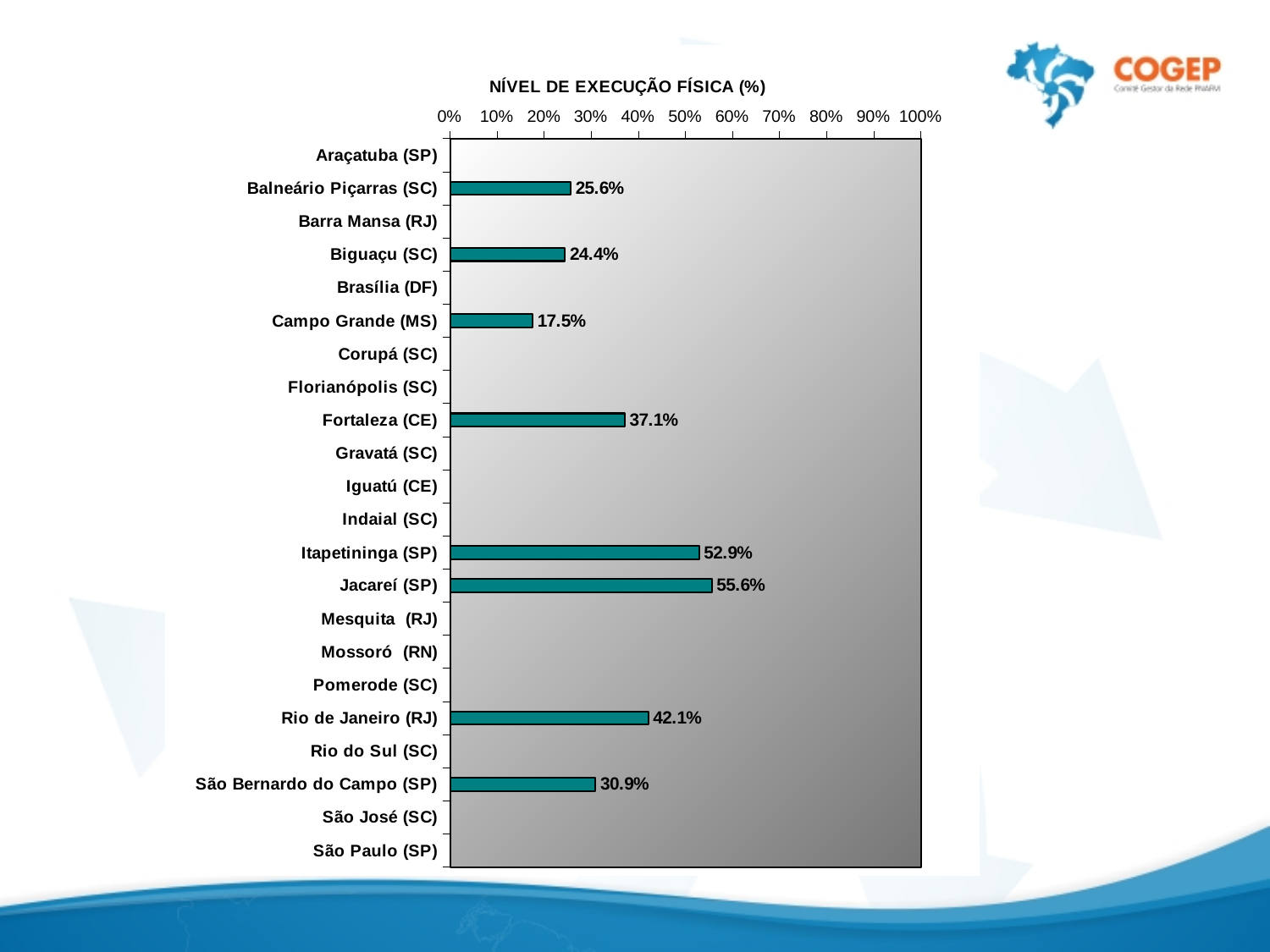
How many cities are listed on the vertical axis of the chart? 22 How many cities have a bar with a value shown in the chart? 8 What is the value for São Bernardo do Campo (SP)? 30.9% What is the difference between the values for Jacareí (SP) and Itapetininga (SP)? 2.7 percentage points What is the value for Fortaleza (CE)? 37.1% Among the cities that have a bar shown, which has the lowest value? Campo Grande (MS) Is the value for Rio de Janeiro (RJ) greater or less than 40%? greater What is the value for Campo Grande (MS)? 17.5% What is the value for Jacareí (SP)? 55.6% What type of chart is shown on the slide? Bar chart Which city has the highest value in the chart? Jacareí (SP) Which is larger, the value for Balneário Piçarras (SC) or the value for Biguaçu (SC)? Balneário Piçarras (SC)